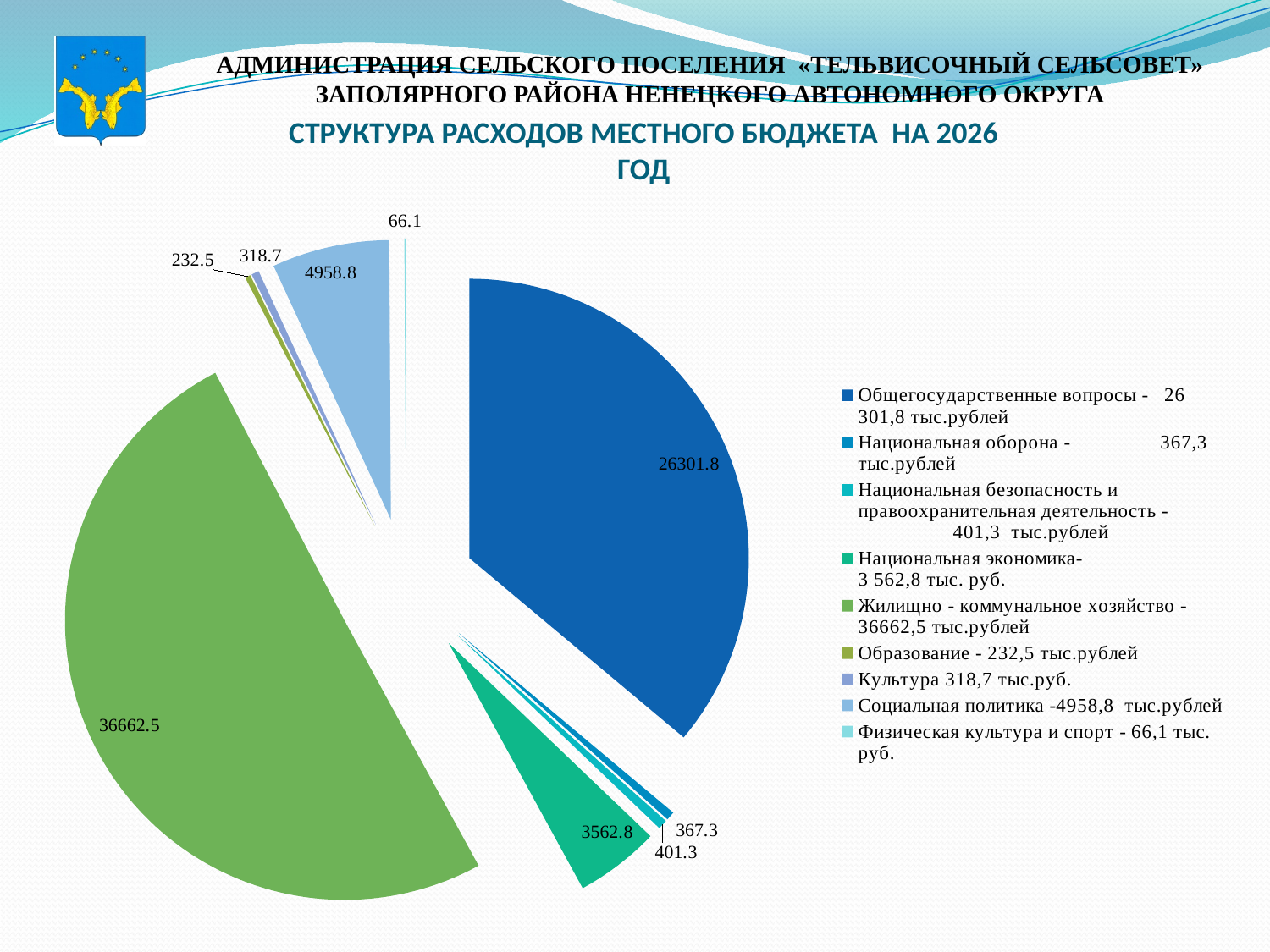
What is the value shown for Жилищно-коммунальное хозяйство? 36662.5 What is the difference between the values for Жилищно-коммунальное хозяйство and Общегосударственные вопросы? 10360.7 What is the value shown for Социальная политика? 4958.8 Which category has the smallest slice of the pie? Физическая культура и спорт What is the title of the chart? СТРУКТУРА РАСХОДОВ МЕСТНОГО БЮДЖЕТА НА 2026 ГОД What is the value shown for Национальная экономика? 3562.8 What type of chart is shown on the slide? pie chart What is the value shown for Общегосударственные вопросы? 26301.8 Which is larger: Национальная оборона or Национальная безопасность и правоохранительная деятельность? Национальная безопасность и правоохранительная деятельность Which category has the largest slice of the pie? Жилищно-коммунальное хозяйство How many categories does the legend list? 9 What is the difference between the values for Социальная политика and Национальная экономика? 1396